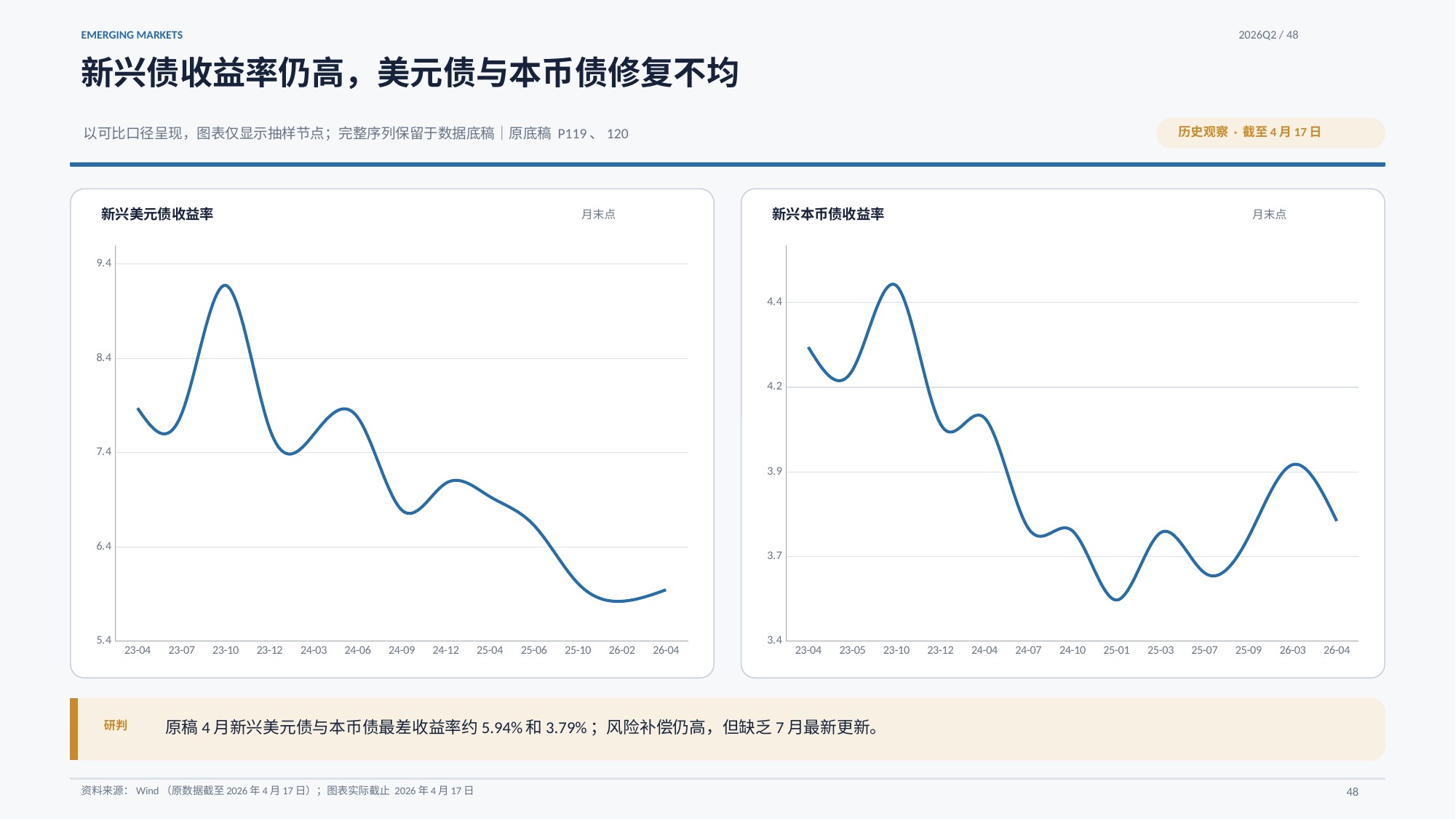
On the 新兴本币债收益率 chart, is the value at 25-01 greater or less than 3.7? less On the 新兴本币债收益率 chart, at which x-axis point is the value highest? 23-10 What kind of chart is the 新兴美元债收益率 chart? line chart On the 新兴本币债收益率 chart, is the value at 23-04 greater or less than 4.2? greater On the 新兴美元债收益率 chart, at which x-axis point is the value highest? 23-10 On the 新兴美元债收益率 chart, is the value at 23-10 greater or less than 8.4? greater On the 新兴美元债收益率 chart, at which x-axis point is the value lowest? 26-02 On the 新兴美元债收益率 chart, do the values overall rise or fall from 23-04 to 26-04? fall How many x-axis points are shown on the 新兴本币债收益率 chart? 13 On the 新兴美元债收益率 chart, which is larger, the value at 23-04 or the value at 26-04? 23-04 On the 新兴本币债收益率 chart, at which x-axis point is the value lowest? 25-01